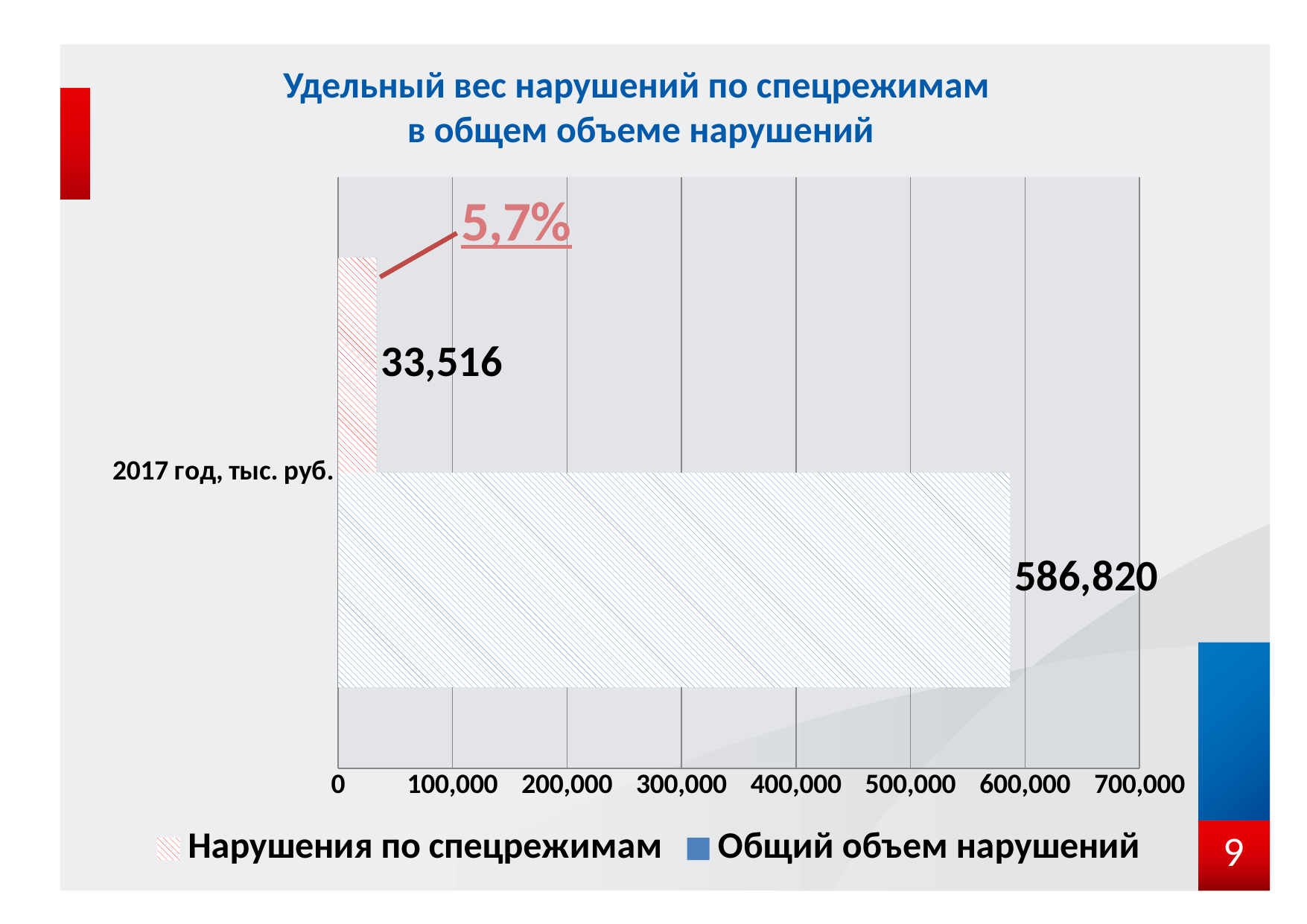
What is the value for "Общий объем нарушений" in 2017? 586,820 What kind of chart is shown on the slide? Bar chart How many series does the legend list? 2 What percentage is shown in the annotation pointing to the "Нарушения по спецрежимам" bar? 5,7% What is the difference between "Общий объем нарушений" and "Нарушения по спецрежимам"? 553,304 Is the value for "Нарушения по спецрежимам" greater or less than 100,000? less What is the label of the category on the vertical axis? 2017 год, тыс. руб. How many categories are shown on the category axis? 1 What is the value for "Нарушения по спецрежимам" in 2017? 33,516 Is the value for "Общий объем нарушений" greater or less than 500,000? greater What is the highest value shown on the horizontal axis? 700,000 Which series has the larger value, "Нарушения по спецрежимам" or "Общий объем нарушений"? Общий объем нарушений